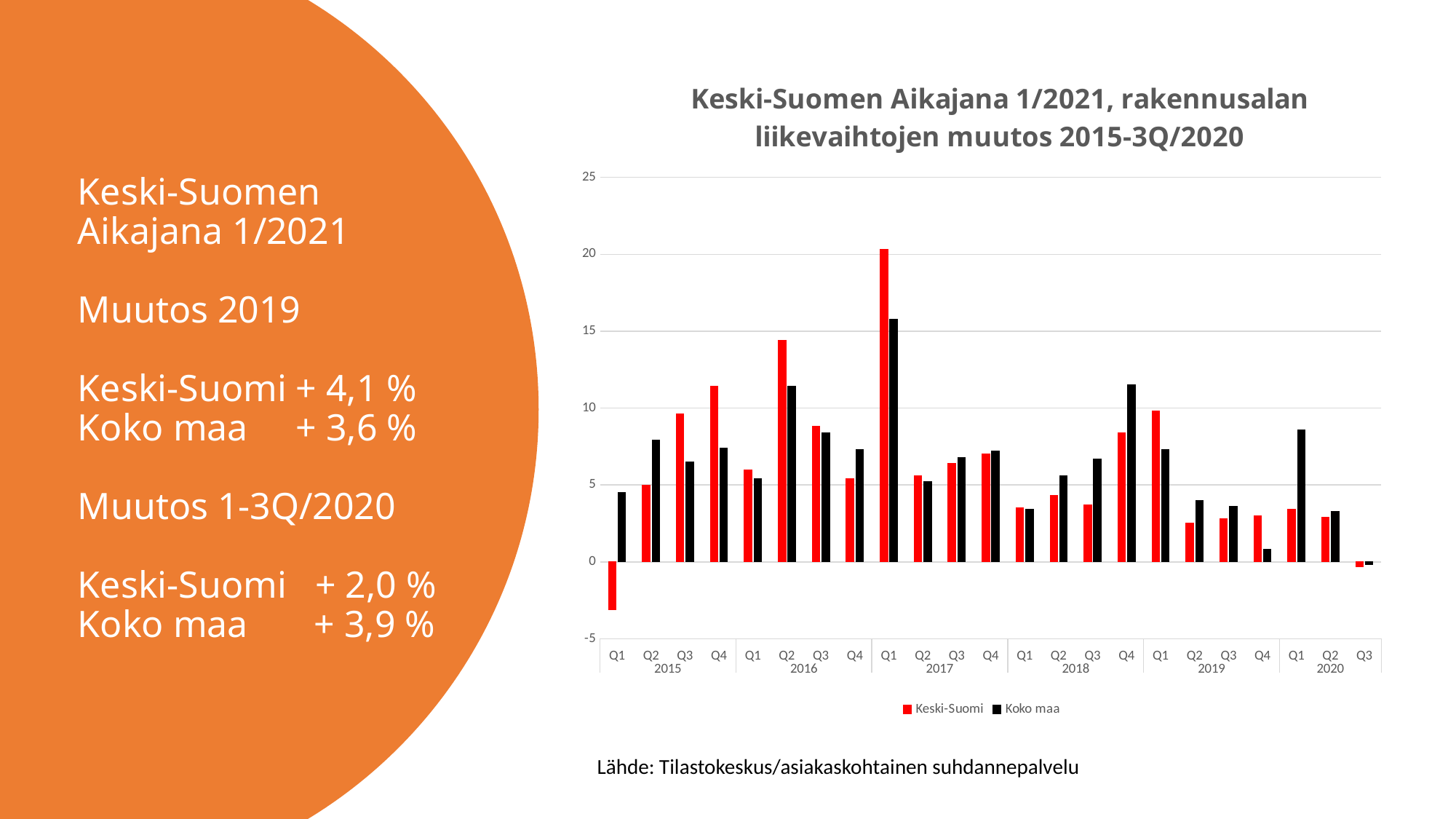
What kind of chart is shown on the slide? bar chart In Q4 2018, which series has the larger value, Keski-Suomi or Koko maa? Koko maa How many series does the chart legend list? 2 What colour are the Keski-Suomi bars in the chart? red In which quarter is the Keski-Suomi value highest? Q1 2017 Is the Keski-Suomi value for Q1 2015 greater or less than 0? less Is the Keski-Suomi value for Q2 2016 greater or less than 10? greater In which quarter is the Keski-Suomi value lowest? Q1 2015 How many quarters are plotted along the x axis of the chart? 23 In which quarter is the Koko maa value highest? Q1 2017 In Q1 2019, which series has the larger value, Keski-Suomi or Koko maa? Keski-Suomi Is the Koko maa value for Q1 2017 greater or less than 15? greater